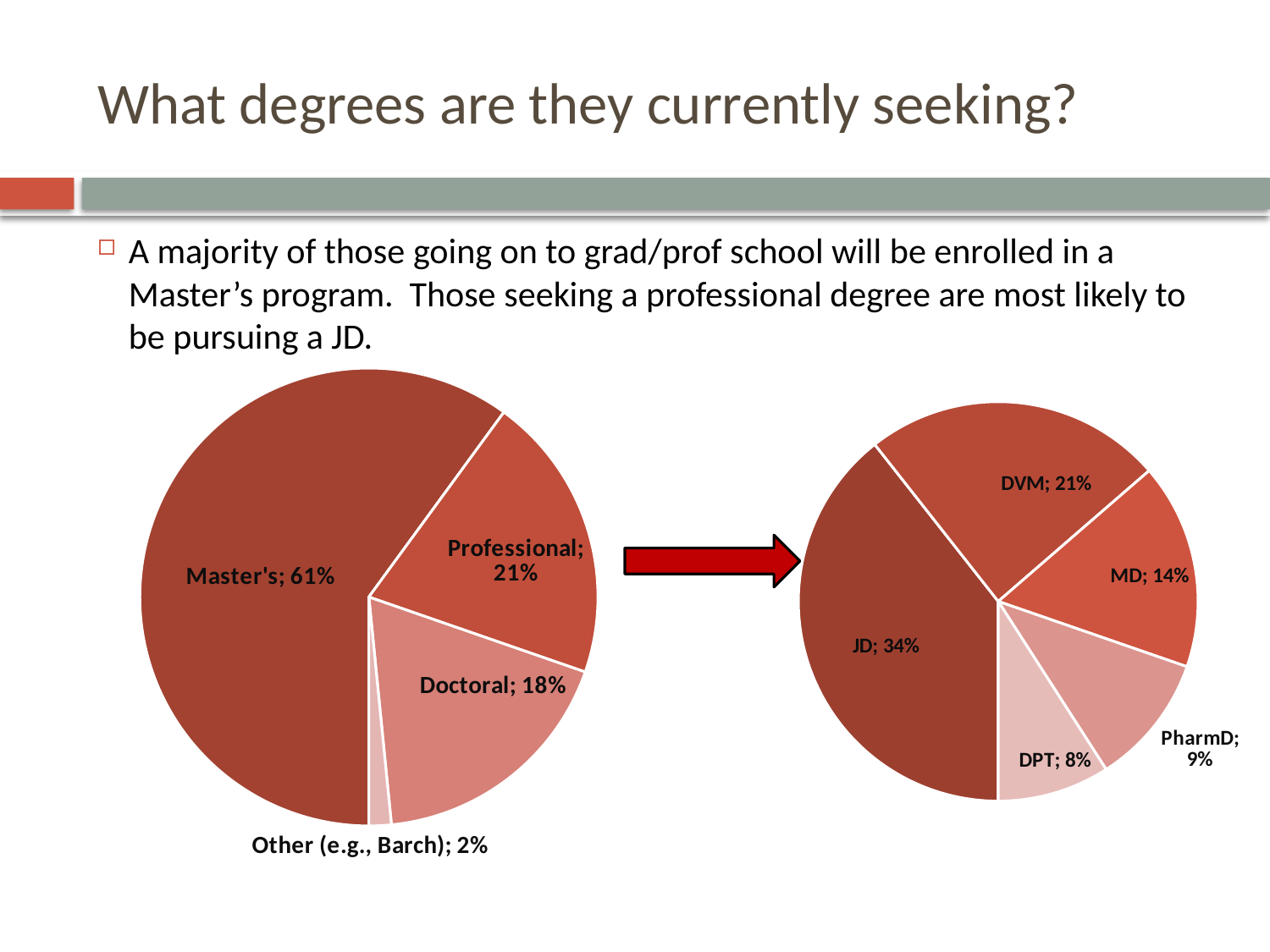
In the left pie chart, what is the difference between the Master's share and the Professional share? 40% In the left pie chart, what share is labelled for Doctoral? 18% In the right pie chart, what share is labelled for DVM? 21% In the right pie chart, what share is labelled for PharmD? 9% In the right pie chart, which category has the largest slice? JD In the right pie chart, which category has the smallest slice? DPT What type of chart is shown on the left of the slide? Pie chart In the left pie chart, how many slices are there? 4 In the right pie chart, what is the difference between the JD share and the MD share? 20% In the left pie chart, which category has the smallest slice? Other (e.g., Barch) In the left pie chart, what share is labelled for Master's? 61% In the right pie chart, which is larger, MD or PharmD? MD